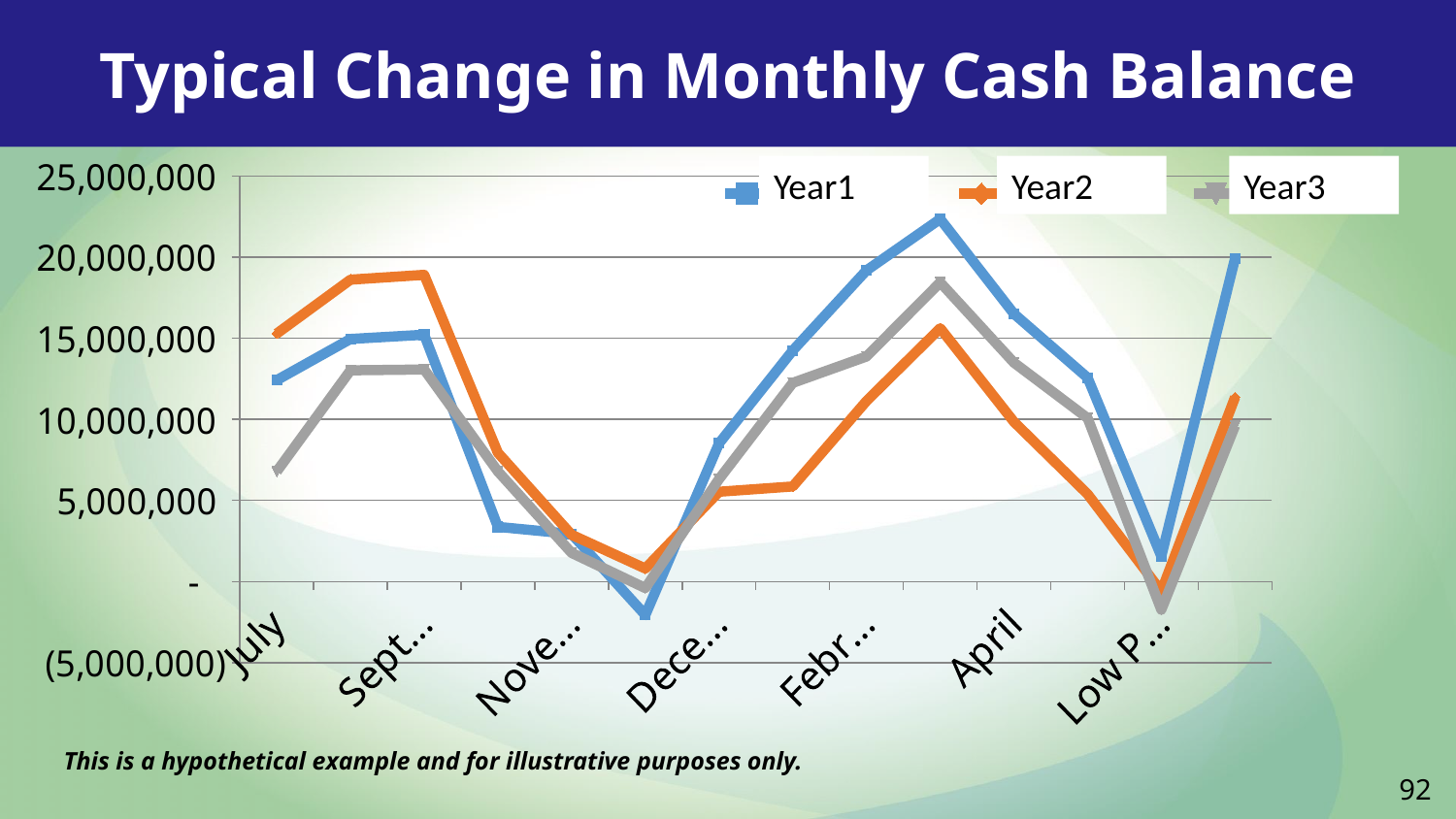
In Febr..., which series has the larger value, Year1 or Year2? Year1 What are the series names shown in the legend? Year1, Year2, Year3 In July, which series has the larger value, Year1 or Year2? Year2 Is the Year3 value for July greater or less than 10,000,000? less What is the title of the chart? Typical Change in Monthly Cash Balance What kind of chart is shown on the slide? line chart Is the Year1 value for Febr... greater or less than 15,000,000? greater At which labeled category does the Year2 line reach its highest value? Sept... Is the Year1 value for July greater or less than 10,000,000? greater How many series does the legend list? 3